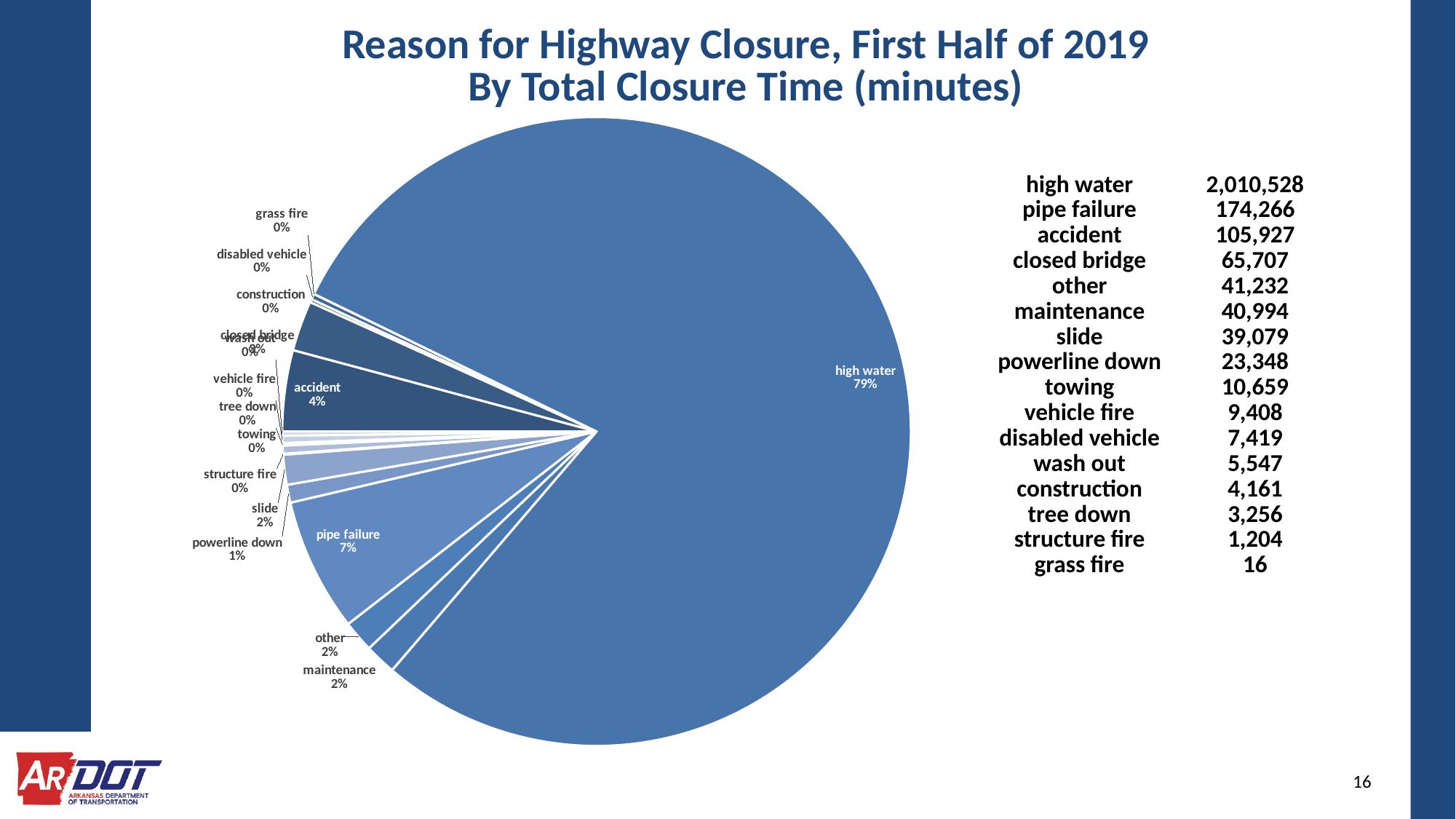
What share of the pie does high water account for? 79% What share of the pie does slide account for? 2% How many reasons for highway closure are shown in the pie chart? 16 What share of the pie does powerline down account for? 1% What kind of chart is shown on the slide? pie chart Which reason for highway closure has the largest slice of the pie? high water What is the total closure time in minutes for pipe failure? 174,266 Which reason for highway closure has the smallest total closure time? grass fire Which has a larger slice of the pie, pipe failure or accident? pipe failure What is the total closure time in minutes for closed bridge? 65,707